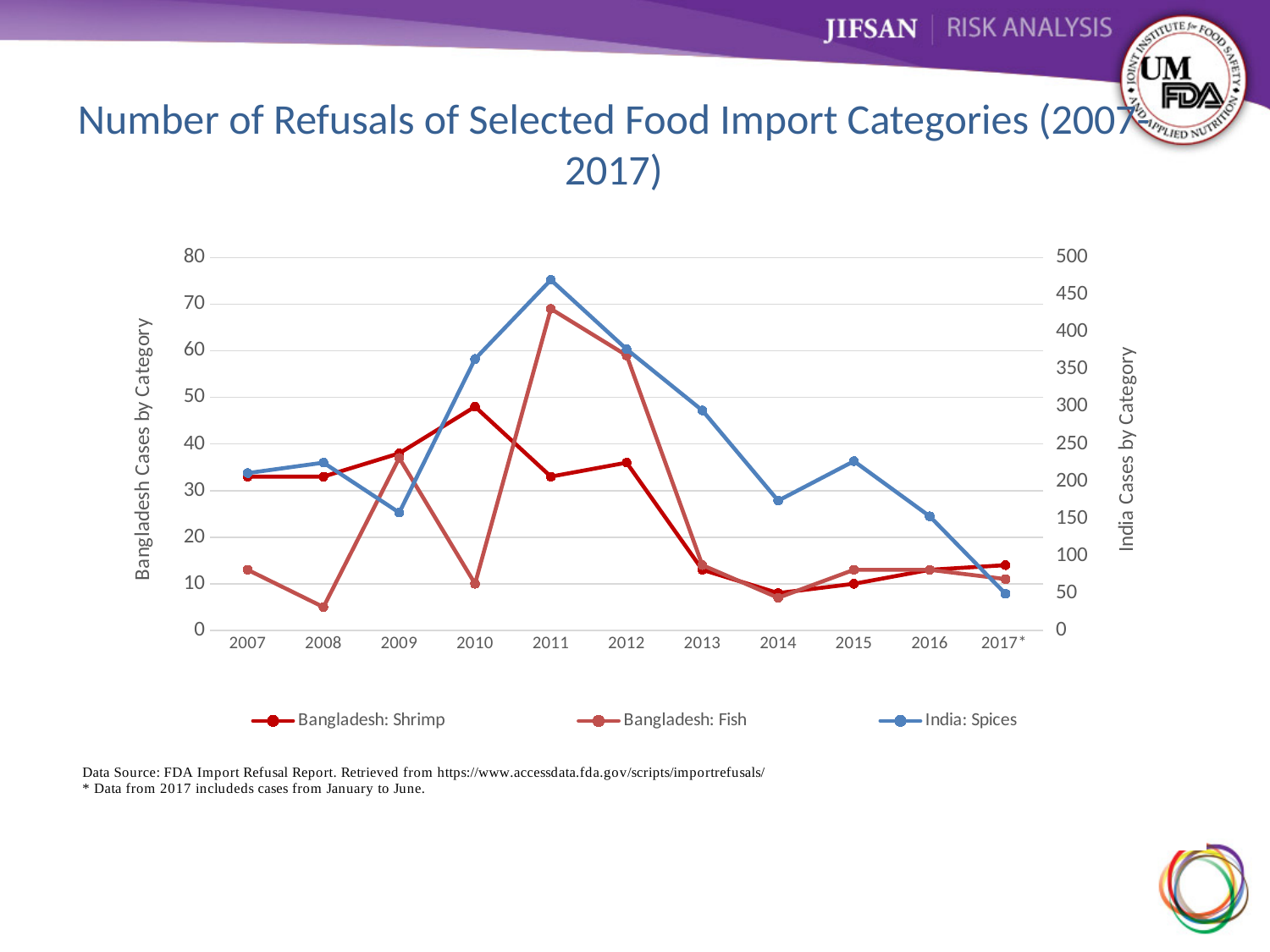
How many years are plotted along the x axis? 11 In which year does the Bangladesh: Fish series reach its highest value? 2011 What kind of chart is shown on the slide? Line chart Is the value for Bangladesh: Fish in 2008 greater or less than 10? less Which is larger in 2012, Bangladesh: Fish or Bangladesh: Shrimp? Bangladesh: Fish How many series does the legend list? 3 Is the value for India: Spices in 2011 greater or less than 450? greater In which year does the India: Spices series reach its lowest value? 2017* Does the India: Spices series rise or fall from 2011 to 2014? Fall In which year does the India: Spices series reach its highest value? 2011 What is the label of the right-hand vertical axis? India Cases by Category In which year does the Bangladesh: Shrimp series reach its highest value? 2010